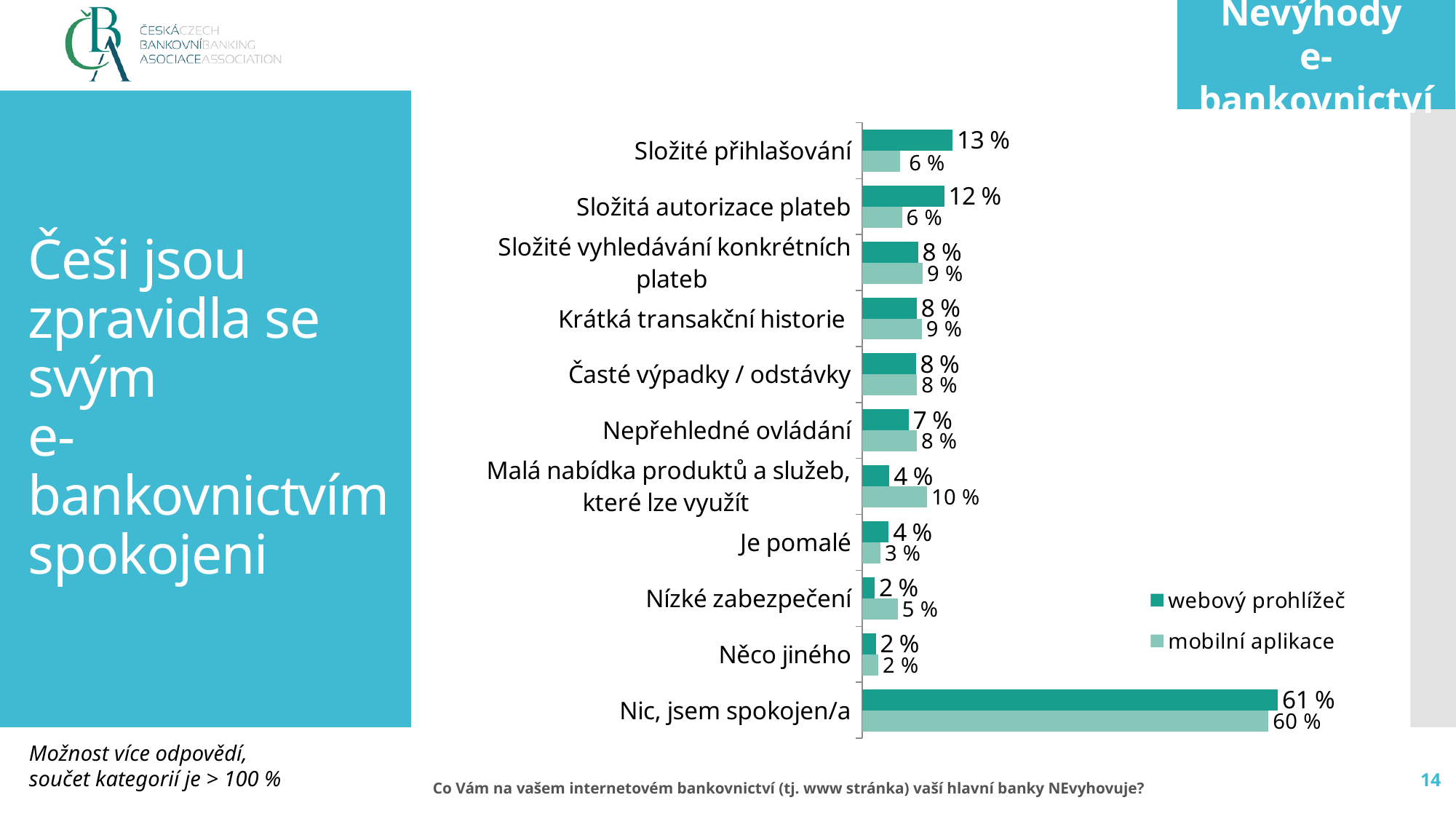
Which category has the lowest value in the "mobilní aplikace" series? Něco jiného For "Složitá autorizace plateb", which series has the larger value: "webový prohlížeč" or "mobilní aplikace"? webový prohlížeč What is the value for "Složité přihlašování" in the "webový prohlížeč" series? 13 % What is the difference between the "webový prohlížeč" and "mobilní aplikace" values for "Složité přihlašování"? 7 % What is the difference between the "mobilní aplikace" and "webový prohlížeč" values for "Malá nabídka produktů a služeb, které lze využít"? 6 % How many categories are shown on the chart? 11 What is the value for "Nízké zabezpečení" in the "mobilní aplikace" series? 5 % Which category has the highest value in the "webový prohlížeč" series? Nic, jsem spokojen/a For "Nízké zabezpečení", which series has the larger value: "webový prohlížeč" or "mobilní aplikace"? mobilní aplikace What kind of chart is shown on the slide? Bar chart What is the value for "Malá nabídka produktů a služeb, které lze využít" in the "mobilní aplikace" series? 10 % How many series does the legend list? 2